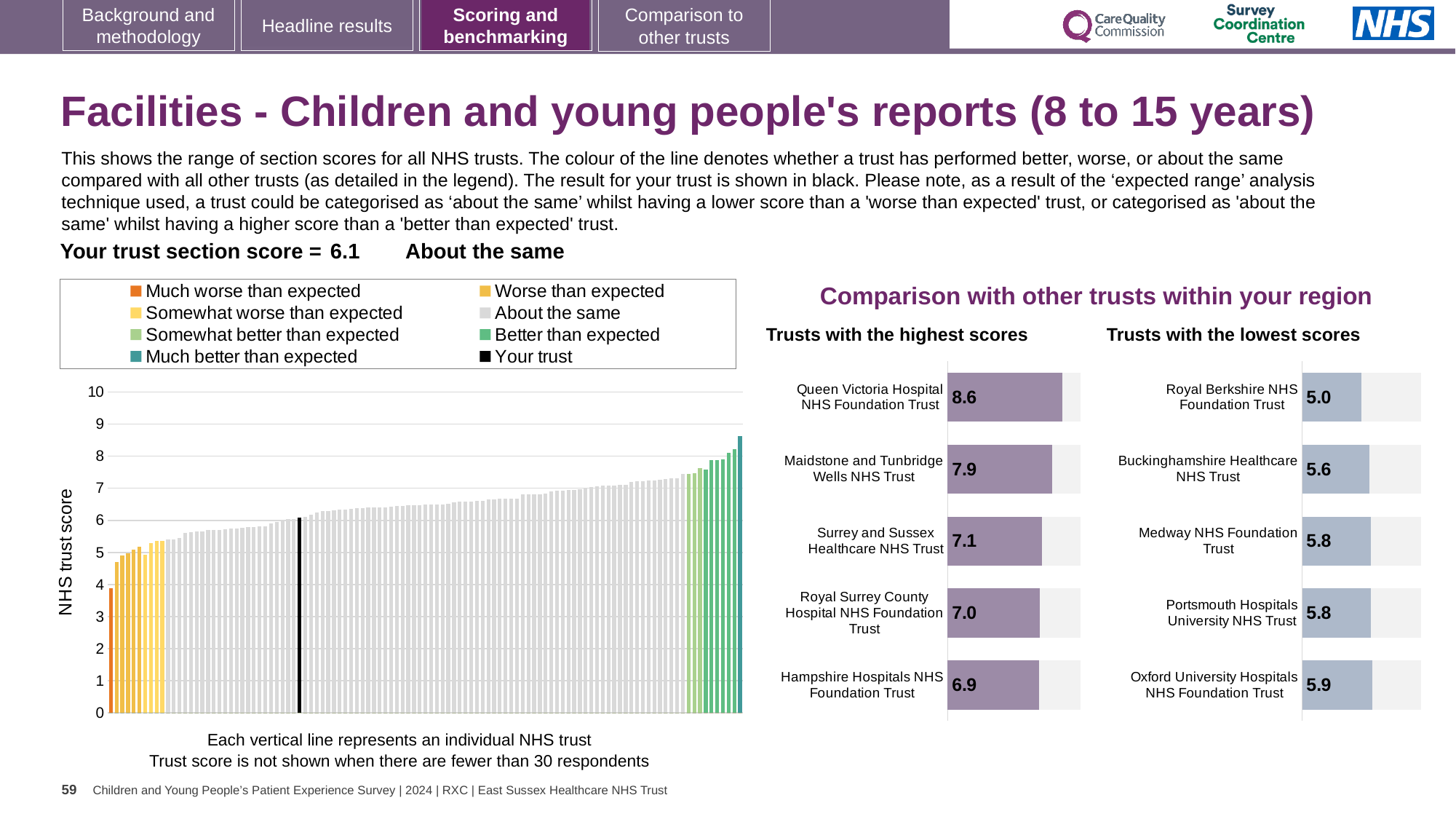
In the 'Trusts with the lowest scores' chart, what is the score for Royal Berkshire NHS Foundation Trust? 5.0 In the 'Trusts with the highest scores' chart, what is the score for Hampshire Hospitals NHS Foundation Trust? 6.9 In the 'Trusts with the lowest scores' chart, what is the score for Oxford University Hospitals NHS Foundation Trust? 5.9 How many entries does the legend above the large chart on the left list? 8 In the 'Trusts with the highest scores' chart, what is the difference between the scores of Queen Victoria Hospital NHS Foundation Trust and Maidstone and Tunbridge Wells NHS Trust? 0.7 In the 'Trusts with the highest scores' chart, what is the score for Queen Victoria Hospital NHS Foundation Trust? 8.6 In the large chart on the left showing the range of NHS trust scores, what is the section score for your trust (the black line)? 6.1 How many trusts are shown in the 'Trusts with the highest scores' chart? 5 In the large chart on the left showing the range of NHS trust scores, do the values rise or fall from left to right? rise In the 'Trusts with the lowest scores' chart, which trust has the lowest score? Royal Berkshire NHS Foundation Trust In the 'Trusts with the lowest scores' chart, which has the larger score: Buckinghamshire Healthcare NHS Trust or Medway NHS Foundation Trust? Medway NHS Foundation Trust In the 'Trusts with the highest scores' chart, which trust has the highest score? Queen Victoria Hospital NHS Foundation Trust